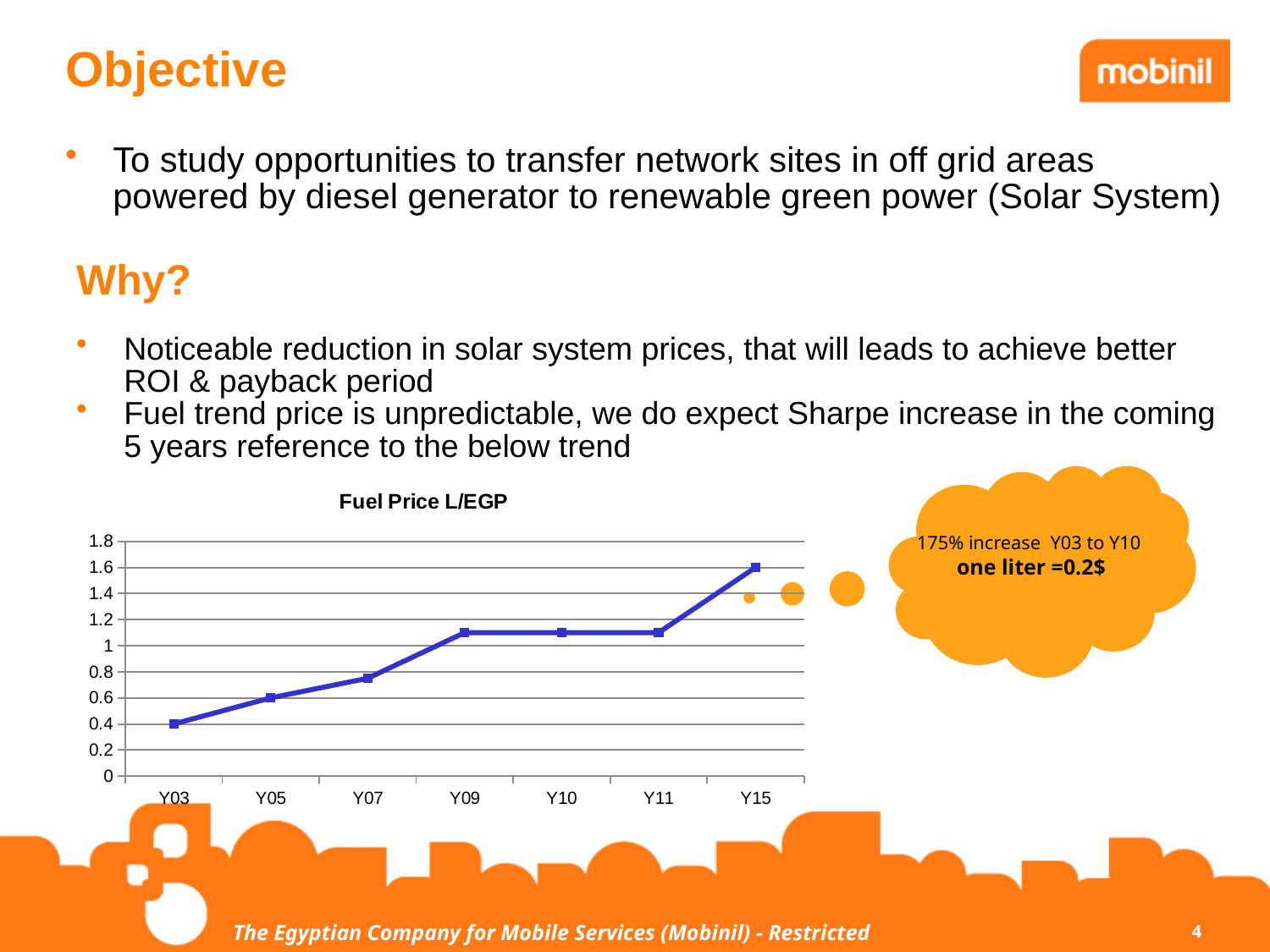
What is the difference between the fuel price in Y15 and in Y03? 1.2 What is the fuel price value for Y03? 0.4 Is the value for Y07 greater or less than 0.6? greater Is the value for Y09 greater or less than 1? greater What kind of chart is shown on the slide? Line chart Which year has the lowest fuel price on the chart? Y03 Do the fuel price values generally rise or fall from Y03 to Y15? Rise How many data points are plotted on the chart? 7 Which year has the highest fuel price on the chart? Y15 What is the fuel price value for Y05? 0.6 What is the fuel price value for Y15? 1.6 What is the title of the chart? Fuel Price L/EGP